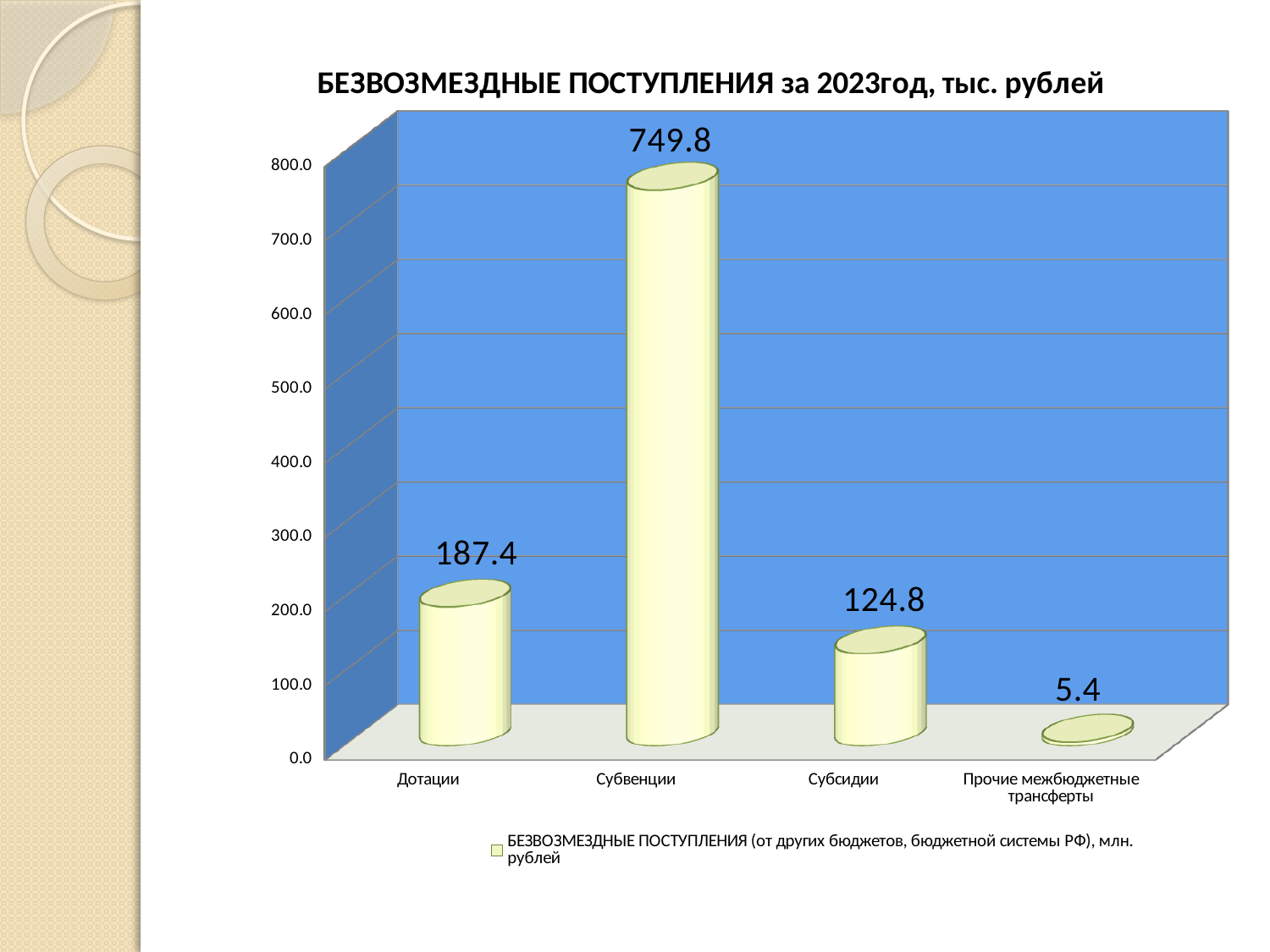
What is the difference between the values for Дотации and Субсидии? 62.6 Which category has the highest value? Субвенции What is the value for Дотации? 187.4 Which is larger, the value for Дотации or the value for Субсидии? Дотации Which category has the lowest value? Прочие межбюджетные трансферты What is the value for Прочие межбюджетные трансферты? 5.4 How many categories are shown on the x axis? 4 What kind of chart is shown on the slide? bar chart What is the title of the chart? БЕЗВОЗМЕЗДНЫЕ ПОСТУПЛЕНИЯ за 2023год, тыс. рублей What is the value for Субвенции? 749.8 Is the value for Субвенции greater or less than 700.0? greater What is the value for Субсидии? 124.8